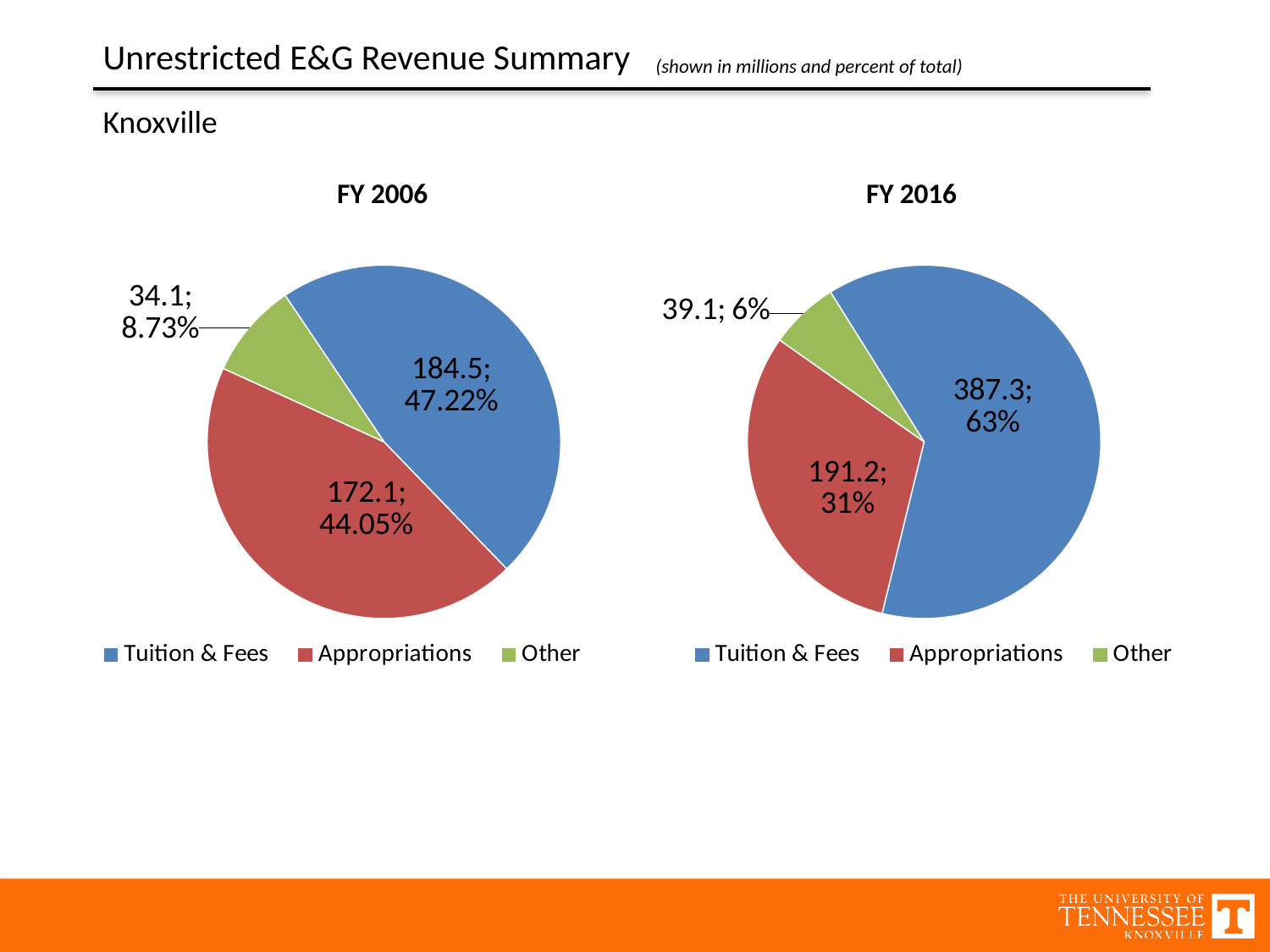
How many entries does the legend of the FY 2006 chart list? 3 What type of chart is used for FY 2006? Pie chart In the FY 2006 pie chart, what percent of the total is Other? 8.73% In the FY 2006 pie chart, what is the value shown for Tuition & Fees? 184.5; 47.22% In the FY 2016 pie chart, what percent of the total is Tuition & Fees? 63% In the FY 2016 pie chart, what is the value shown for Appropriations? 191.2; 31% In the FY 2016 pie chart, which category is the largest? Tuition & Fees In the FY 2016 pie chart, what colour represents Other? Green In the FY 2006 pie chart, what is the difference in millions between Tuition & Fees and Appropriations? 12.4 How many categories does the FY 2016 pie chart show? 3 In the FY 2016 pie chart, which is larger, Appropriations or Other? Appropriations In the FY 2006 pie chart, which category is the smallest? Other